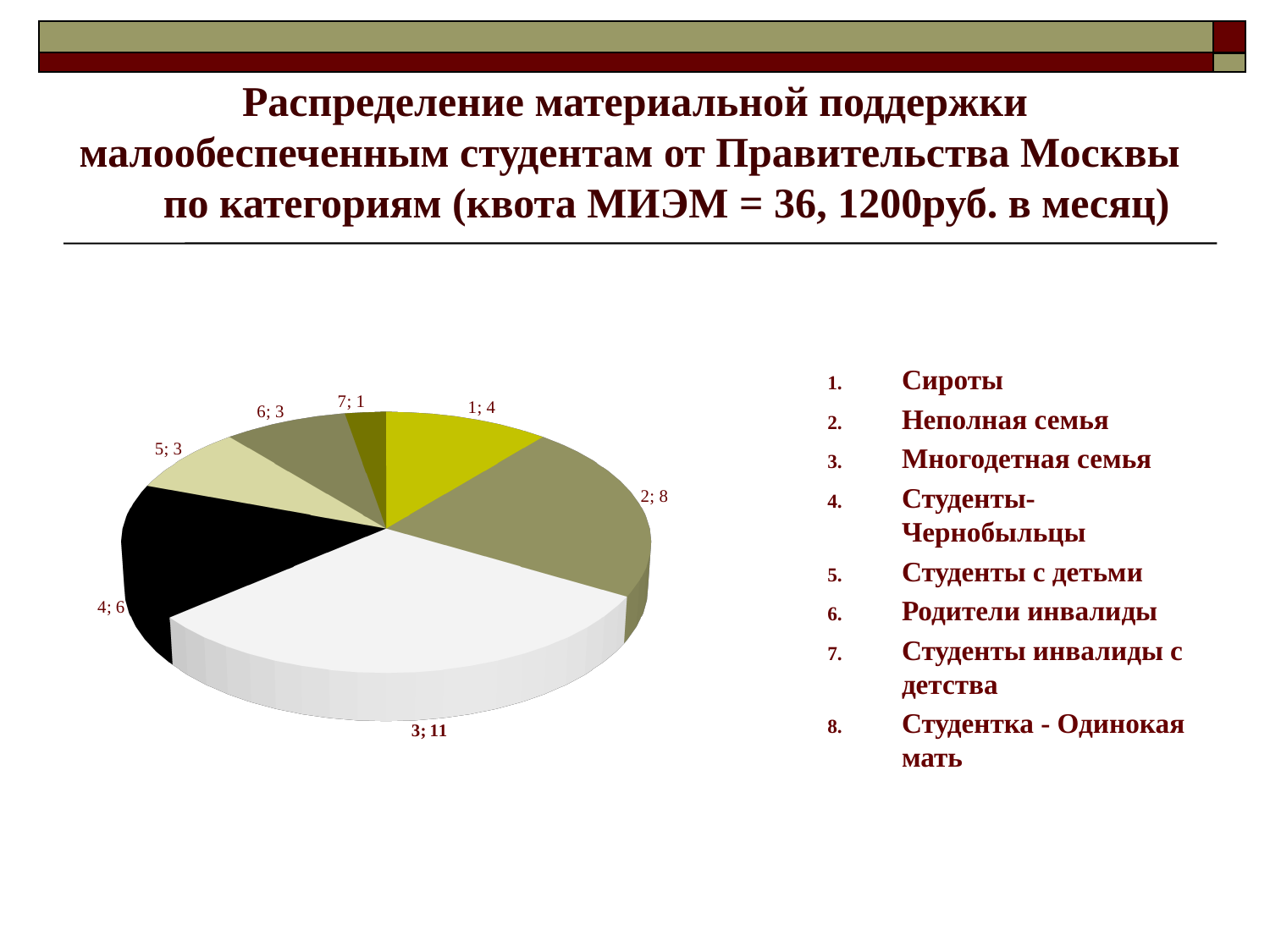
What value is shown for slice 4 (Студенты-Чернобыльцы) in the pie chart? 6 Which category is listed as number 8 in the list next to the chart? Студентка - Одинокая мать What value is shown for slice 1 (Сироты) in the pie chart? 4 What kind of chart is shown on the slide? Pie chart How many slices are labelled in the pie chart? 7 Which slice has the largest value in the pie chart? 3 (Многодетная семья) Which slice has the smallest value in the pie chart? 7 (Студенты инвалиды с детства) What is the difference between the values of slice 3 and slice 2? 3 What value is shown for slice 2 (Неполная семья) in the pie chart? 8 What is the total of all the labelled slice values in the pie chart? 36 Which is larger: the value for slice 4 or the value for slice 1? Slice 4 What value is shown for slice 3 (Многодетная семья) in the pie chart? 11